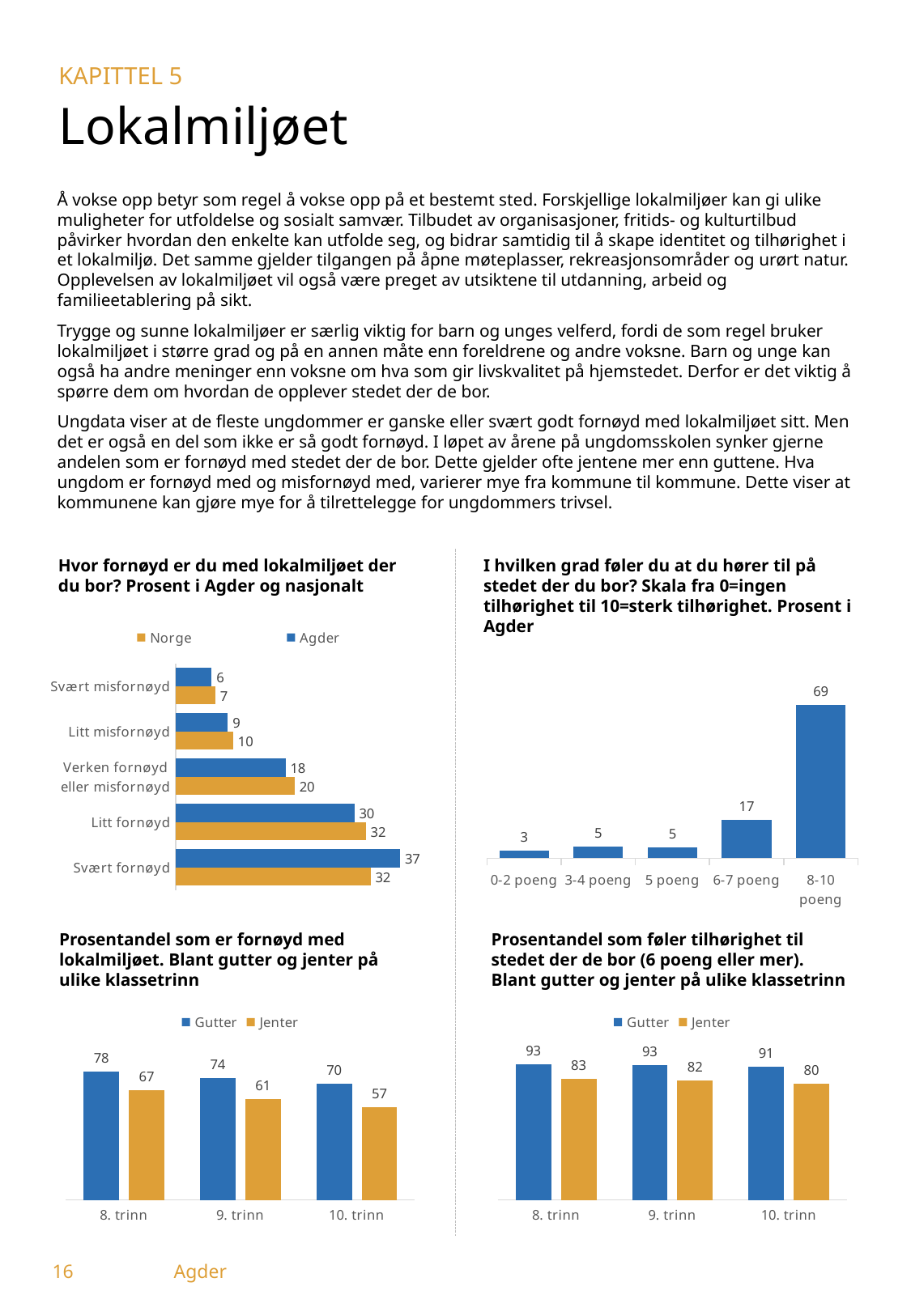
In the top-right chart (I hvilken grad føler du at du hører til på stedet der du bor?), what is the value for 6-7 poeng? 17 In the top-left chart (Hvor fornøyd er du med lokalmiljøet der du bor?), what is the Norge value for Verken fornøyd eller misfornøyd? 20 In the bottom-left chart (Prosentandel som er fornøyd med lokalmiljøet), what is the difference between Gutter and Jenter at 9. trinn? 13 In the top-left chart (Hvor fornøyd er du med lokalmiljøet der du bor?), what is the Agder value for Svært fornøyd? 37 In the bottom-left chart (Prosentandel som er fornøyd med lokalmiljøet), what is the Jenter value for 10. trinn? 57 In the top-left chart (Hvor fornøyd er du med lokalmiljøet der du bor?), how many series does the legend list? 2 In the bottom-left chart (Prosentandel som er fornøyd med lokalmiljøet), do the Gutter values rise or fall from 8. trinn to 10. trinn? fall What kind of chart is the bottom-right chart (Prosentandel som føler tilhørighet til stedet der de bor)? bar chart In the top-right chart (I hvilken grad føler du at du hører til på stedet der du bor?), how many categories are shown on the x axis? 5 In the top-right chart (I hvilken grad føler du at du hører til på stedet der du bor?), which category has the highest value? 8-10 poeng In the bottom-right chart (Prosentandel som føler tilhørighet til stedet der de bor), which is larger at 8. trinn, Gutter or Jenter? Gutter In the top-left chart (Hvor fornøyd er du med lokalmiljøet der du bor?), what is the difference between the Agder and Norge values for Svært fornøyd? 5